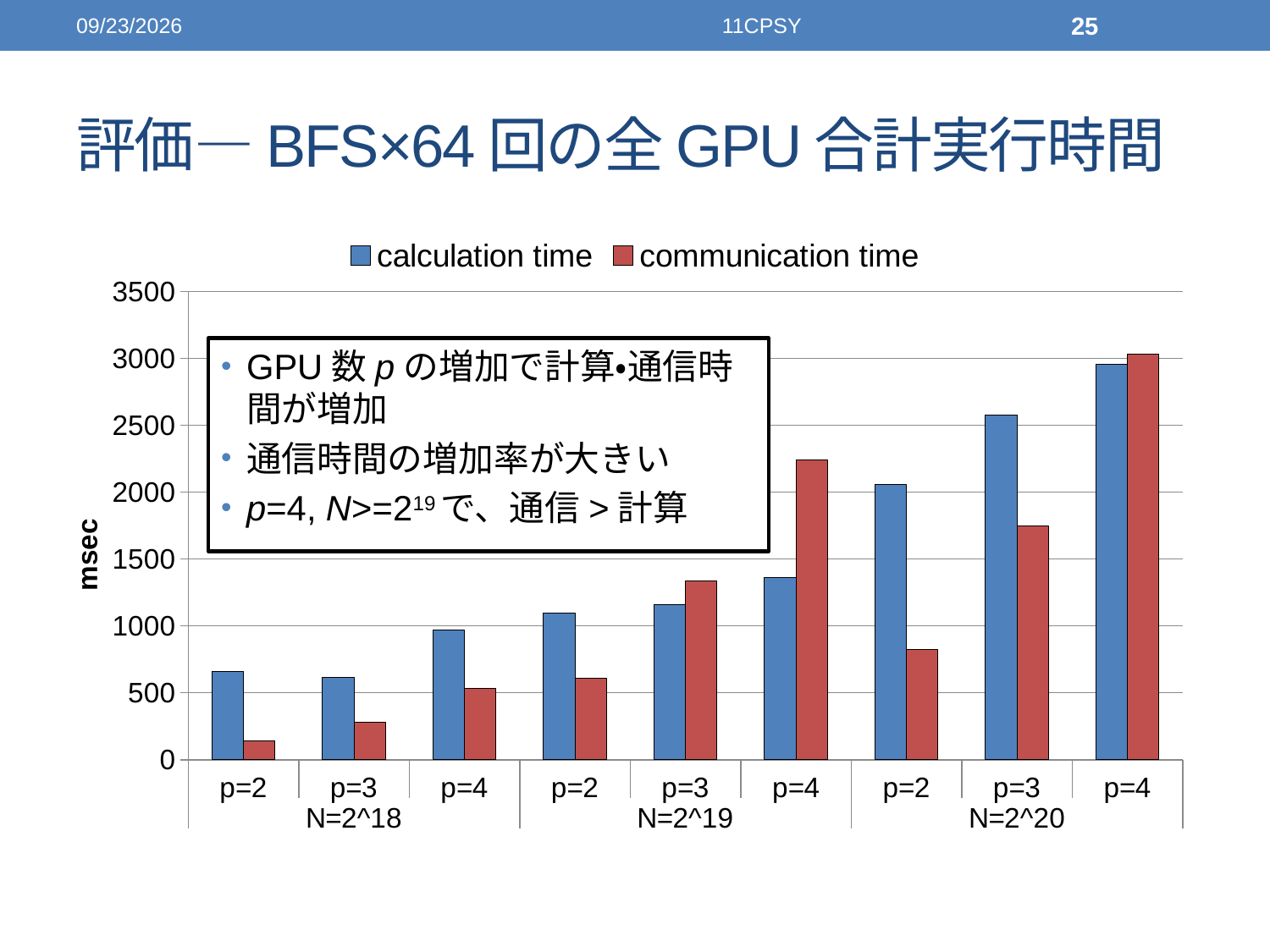
How many series does the legend list? 2 Which category has the highest communication time? p=4, N=2^20 Is the communication time for p=2 at N=2^20 greater or less than 1000? less Is the calculation time for p=4 at N=2^20 greater or less than 2500? greater Which category has the highest calculation time? p=4, N=2^20 What kind of chart is shown on the slide? bar chart What is the label on the y axis of the chart? msec Which category has the lowest communication time? p=2, N=2^18 How many categories (p values across all N groups) are plotted on the x axis? 9 Is the communication time for p=4 at N=2^19 greater or less than 2000? greater For p=2 at N=2^20, which is larger: calculation time or communication time? calculation time For p=4 at N=2^19, which is larger: calculation time or communication time? communication time